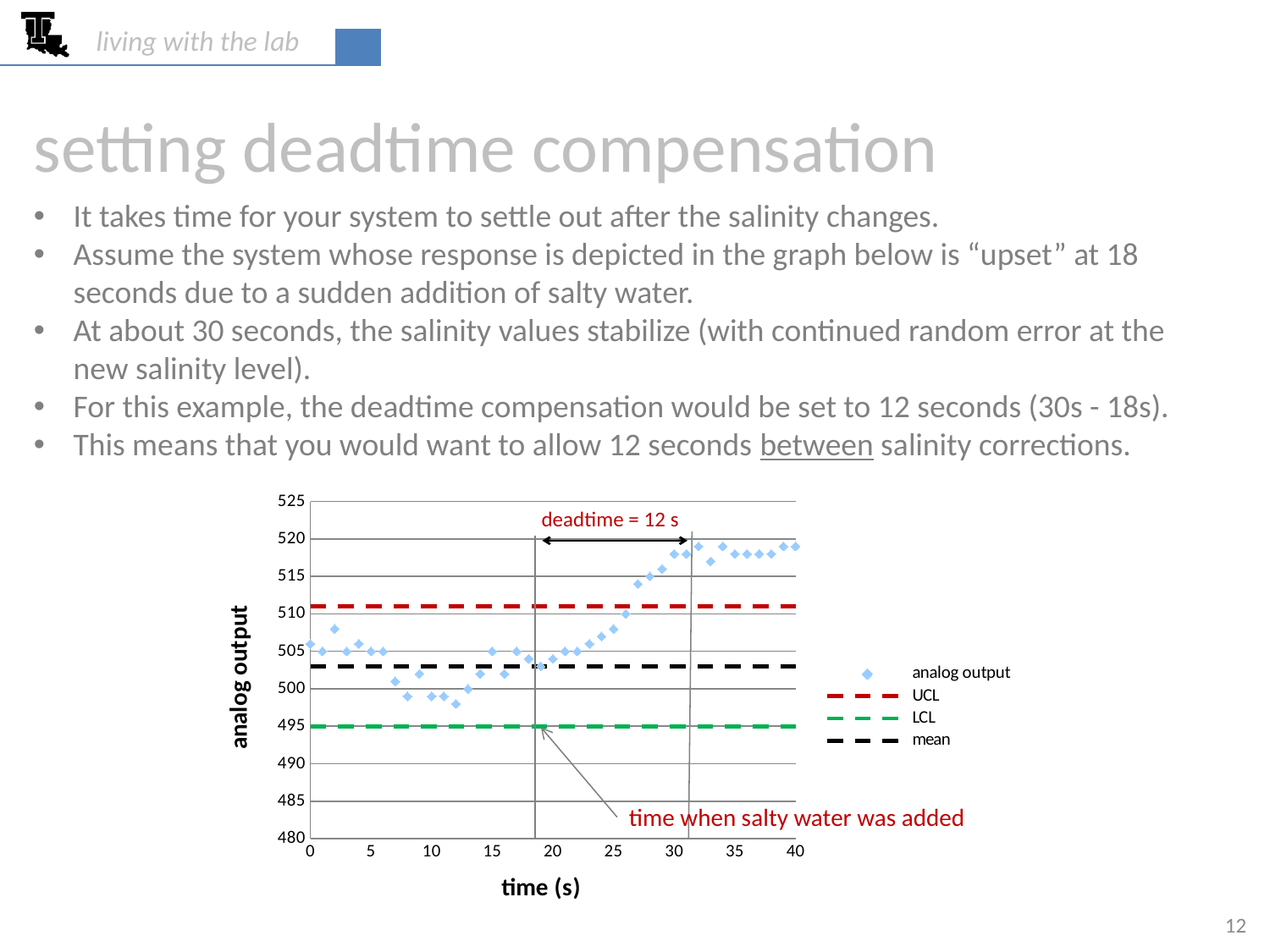
What are the four entries in the chart legend? analog output, UCL, LCL, mean Is the mean line greater or less than 500? greater What deadtime value is annotated on the chart? 12 s Which is larger, the analog output value at 35 seconds or at 10 seconds? 35 seconds Is the analog output value at 12 seconds greater or less than 500? less What kind of chart is shown on the slide? scatter chart Is the analog output value at 0 seconds greater or less than 510? less How many series does the chart legend list? 4 What is the label of the x axis of the chart? time (s) Do the analog output values rise or fall between 18 seconds and 30 seconds? rise